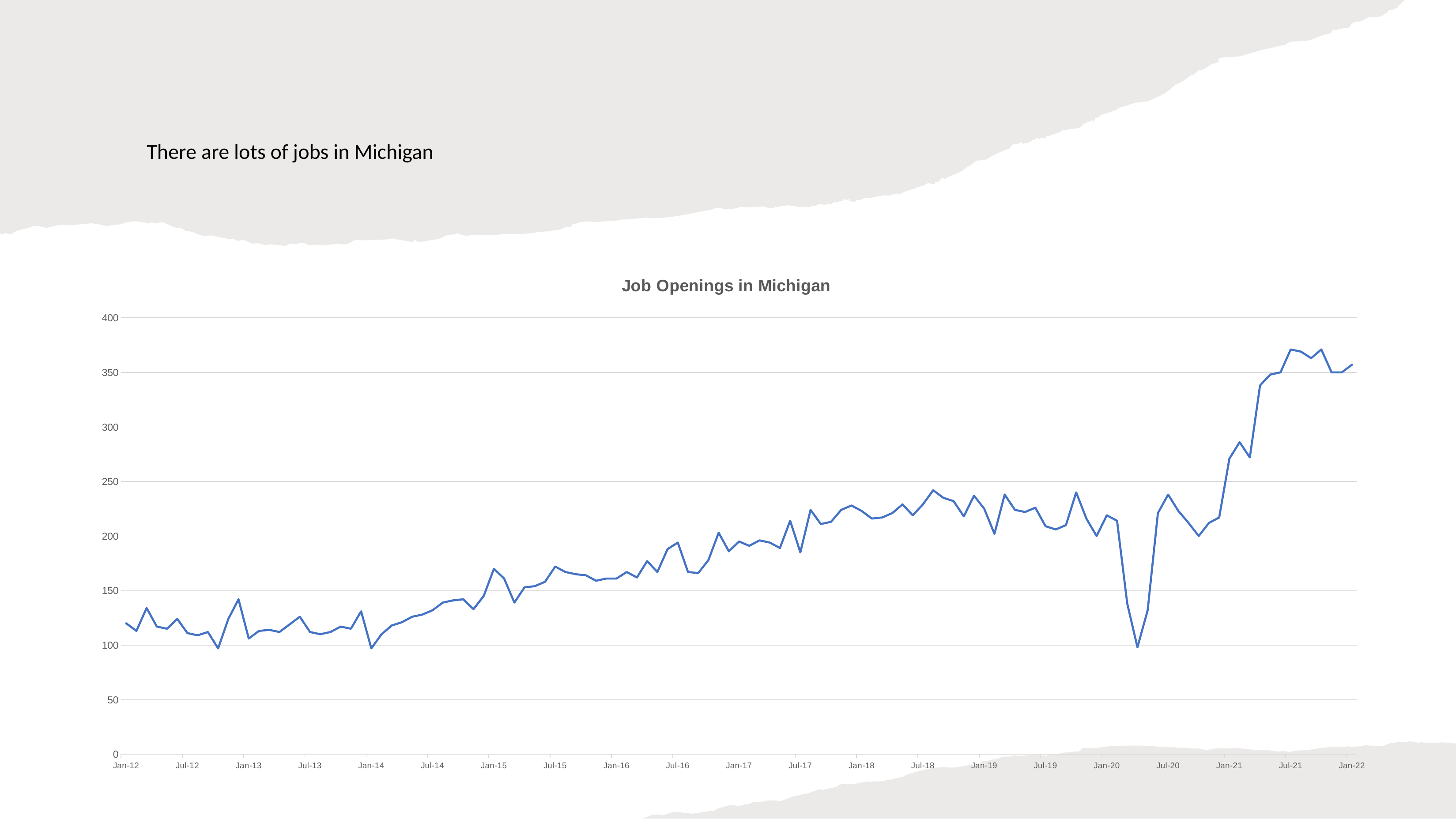
Is the value for Jan-19 greater or less than 250? less Which is larger, the value for Jan-22 or the value for Jan-12? Jan-22 Is the value for Jan-15 greater or less than 150? greater Is the value for Jan-16 greater or less than 200? less Which is larger, the value for Jan-19 or the value for Jan-13? Jan-19 What is the title of the chart? Job Openings in Michigan Overall, do job openings in Michigan rise or fall from Jan-12 to Jan-22? rise What is the highest value shown on the y axis? 400 What kind of chart is shown on the slide? line chart